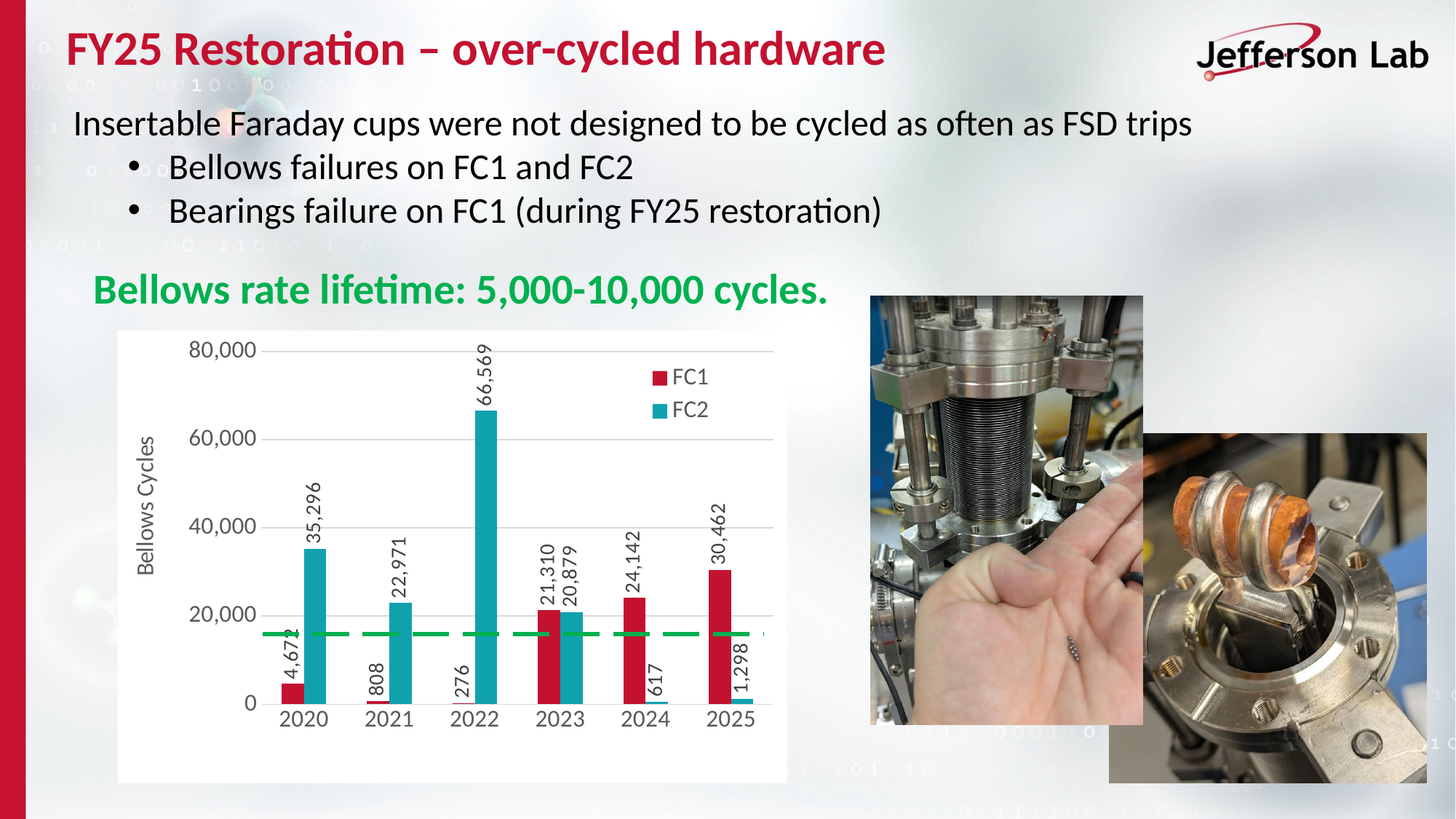
What is the FC2 value for 2022? 66,569 What kind of chart is shown on the slide? Bar chart What is the difference between the FC1 and FC2 values in 2023? 431 Is the FC2 value for 2020 greater or less than 20,000? greater What is the FC1 value for 2024? 24,142 In which year is the FC1 value lowest? 2022 In which year is the FC2 value highest? 2022 How many years are shown on the x axis? 6 How many series does the legend list? 2 What is the FC2 value for 2021? 22,971 What is the FC1 value for 2025? 30,462 Which is larger in 2024, the FC1 value or the FC2 value? FC1